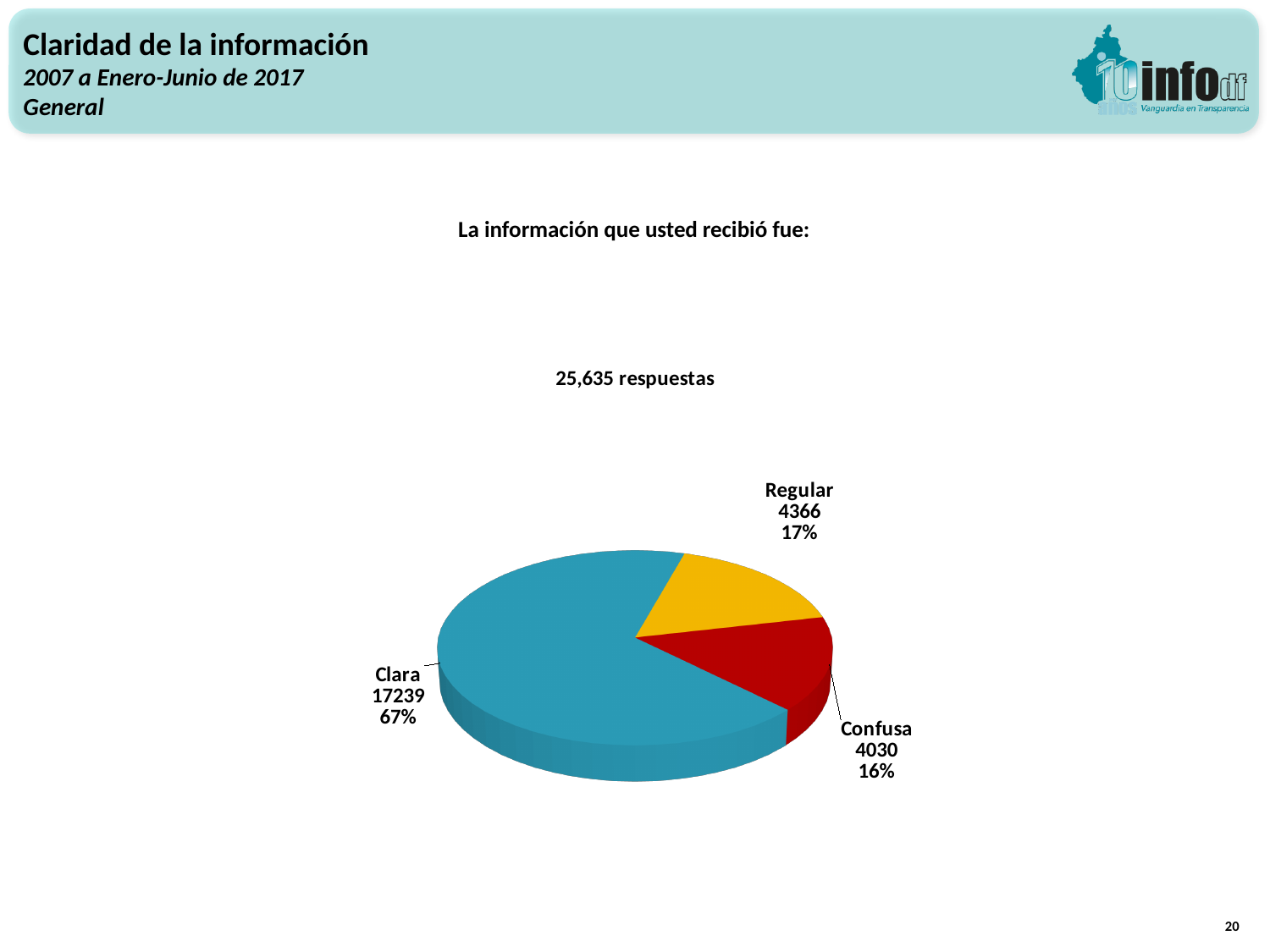
What is the value for Confusa? 4030 Which category has the smallest slice? Confusa What is the value for Regular? 4366 How many slices does the pie chart have? 3 What kind of chart is shown on the slide? pie chart What is the value for Clara? 17239 Which category has the largest slice? Clara How many total responses does the slide report for the chart? 25,635 respuestas What is the difference between the values for Regular and Confusa? 336 What share of the pie does Confusa represent? 16% What share of the pie does Clara represent? 67% Which is larger, the value for Clara or the value for Regular? Clara